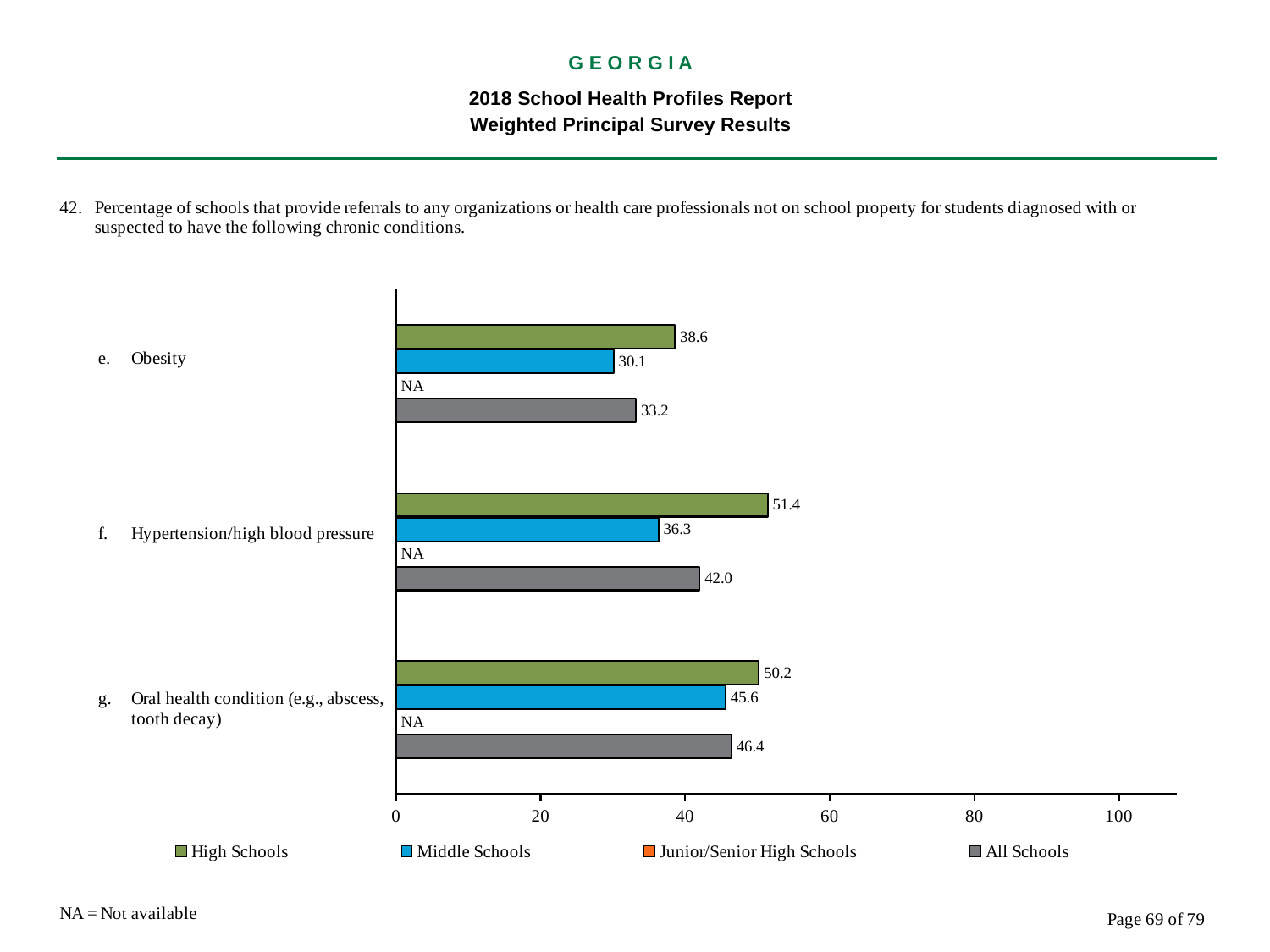
What kind of chart is shown on the slide? bar chart What is the value for All Schools for Oral health condition (e.g., abscess, tooth decay)? 46.4 How many chronic conditions are shown on the chart? 3 What is shown for Junior/Senior High Schools for Obesity? NA What is the value for Middle Schools for Hypertension/high blood pressure? 36.3 Which condition has the lowest value for Middle Schools? Obesity Which is larger for Oral health condition: the High Schools value or the All Schools value? High Schools How many series does the legend list? 4 What is the value for High Schools for Obesity? 38.6 What is the difference between the High Schools and Middle Schools values for Hypertension/high blood pressure? 15.1 Is the All Schools value for Obesity greater or less than 40? less Which condition has the highest value for High Schools? Hypertension/high blood pressure